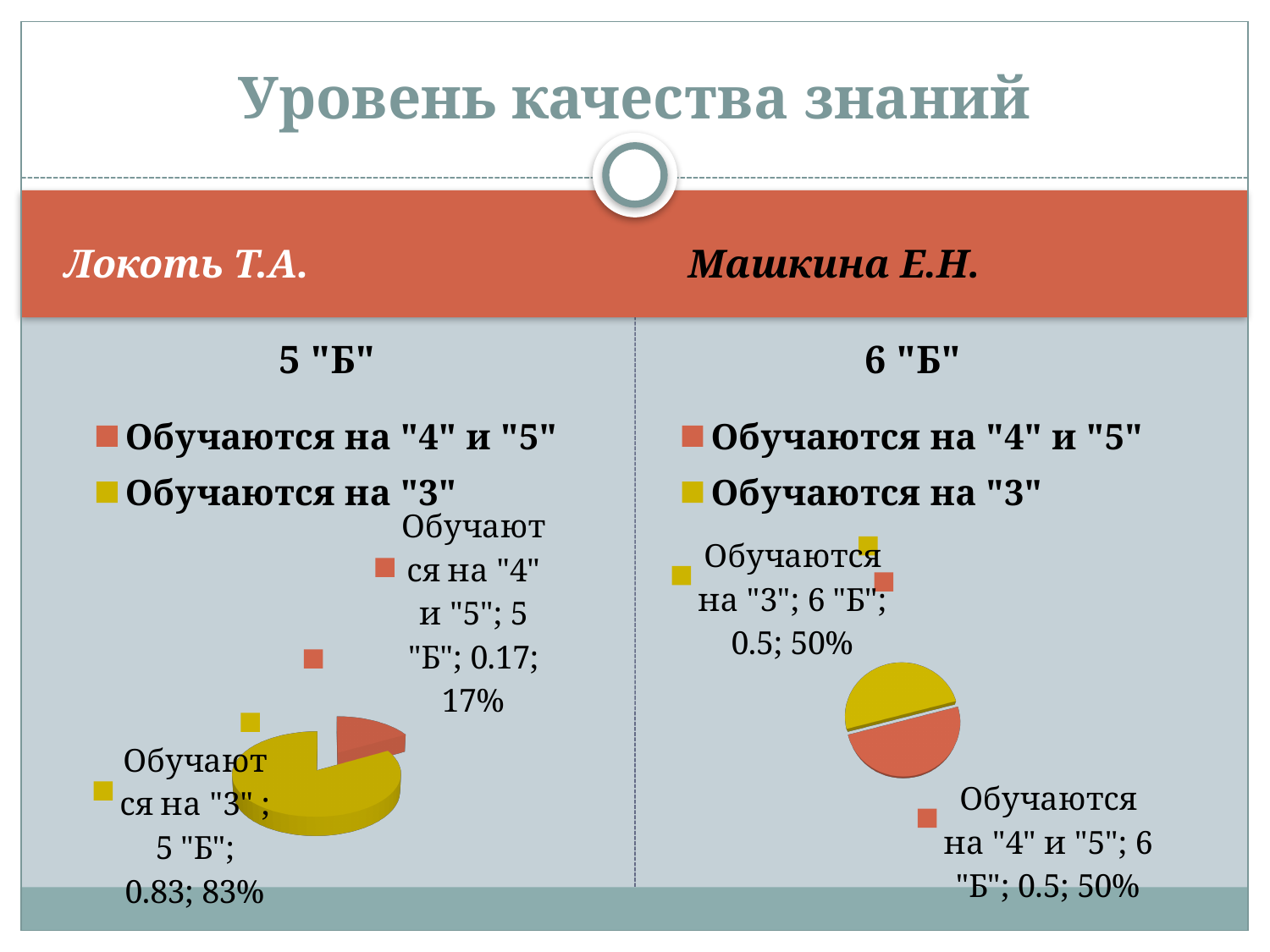
How many entries does the legend of the 5 "Б" chart on the left list? 2 What type of chart is used for 5 "Б" on the left? Pie chart How many categories does the 6 "Б" chart on the right show? 2 What is the title of the slide containing the two pie charts? Уровень качества знаний In the 5 "Б" chart on the left, what is the difference in percentage points between "Обучаются на "3"" and "Обучаются на "4" и "5""? 66 In the 6 "Б" chart on the right, what percentage of students are shown for "Обучаются на "3""? 50% In the 5 "Б" chart on the left, what percentage of students are shown for "Обучаются на "4" и "5""? 17% In the 5 "Б" chart on the left, what percentage of students are shown for "Обучаются на "3""? 83% In the 6 "Б" chart on the right, what percentage of students are shown for "Обучаются на "4" и "5""? 50% In the 5 "Б" chart on the left, which is larger: the share for "Обучаются на "3"" or for "Обучаются на "4" и "5""? Обучаются на "3" In the 5 "Б" chart on the left, which category has the smallest slice? Обучаются на "4" и "5" In the 5 "Б" chart on the left, which category has the largest slice? Обучаются на "3"